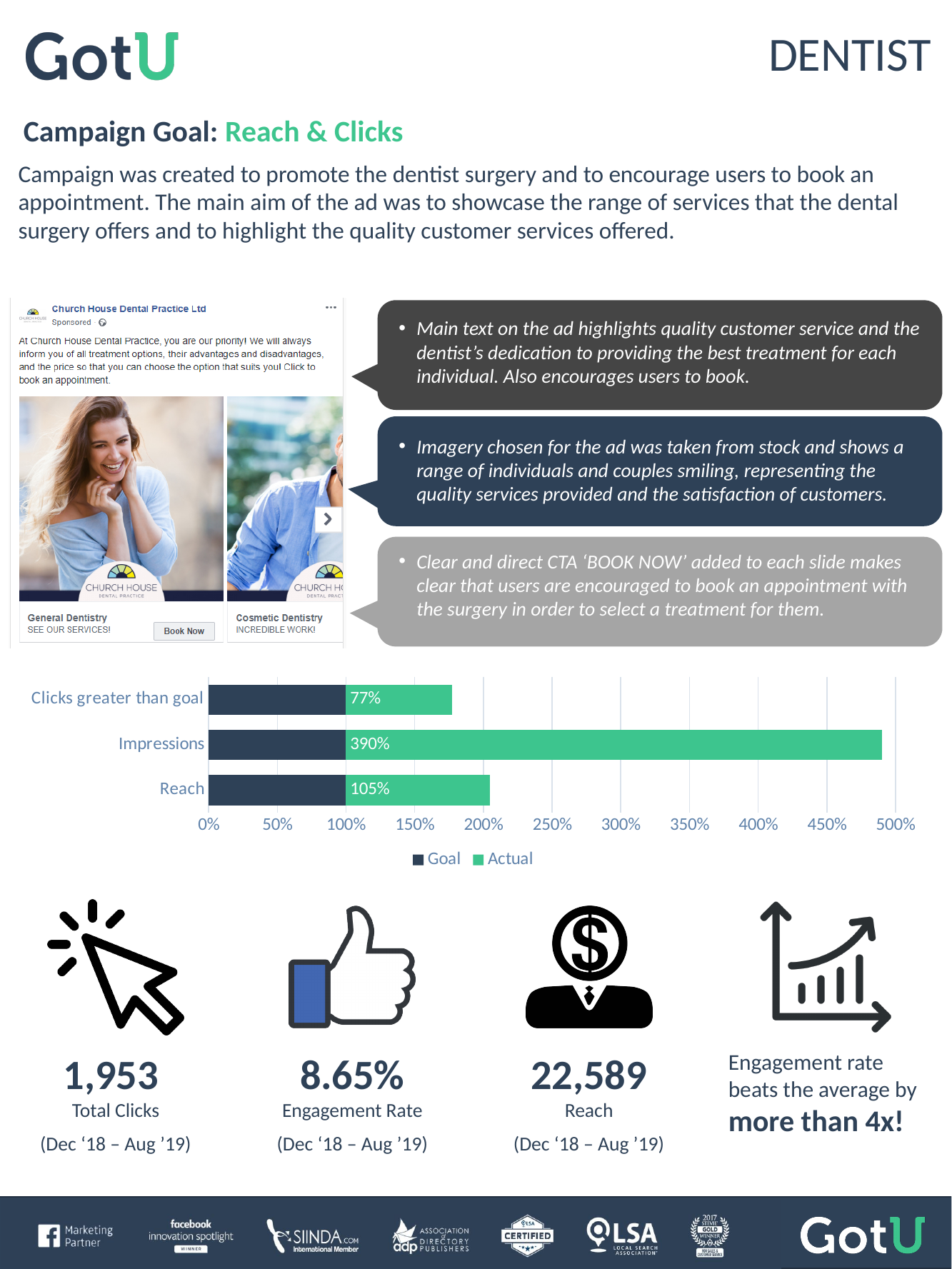
How many series does the chart legend list? 2 How many categories does the bar chart show? 3 Is the Actual value for Reach larger or smaller than the Actual value for Clicks greater than goal? larger What kind of chart is shown on the slide? bar chart What are the two series named in the chart legend? Goal and Actual What is the Actual value labelled for Clicks greater than goal? 77% Is the total length of the Impressions bar (Goal plus Actual) greater or less than 450%? greater Which category has the highest Actual value? Impressions What is the difference between the Actual values for Impressions and Reach? 285% Which category has the lowest Actual value? Clicks greater than goal What is the Actual value labelled for Impressions? 390% What is the Actual value labelled for Reach? 105%